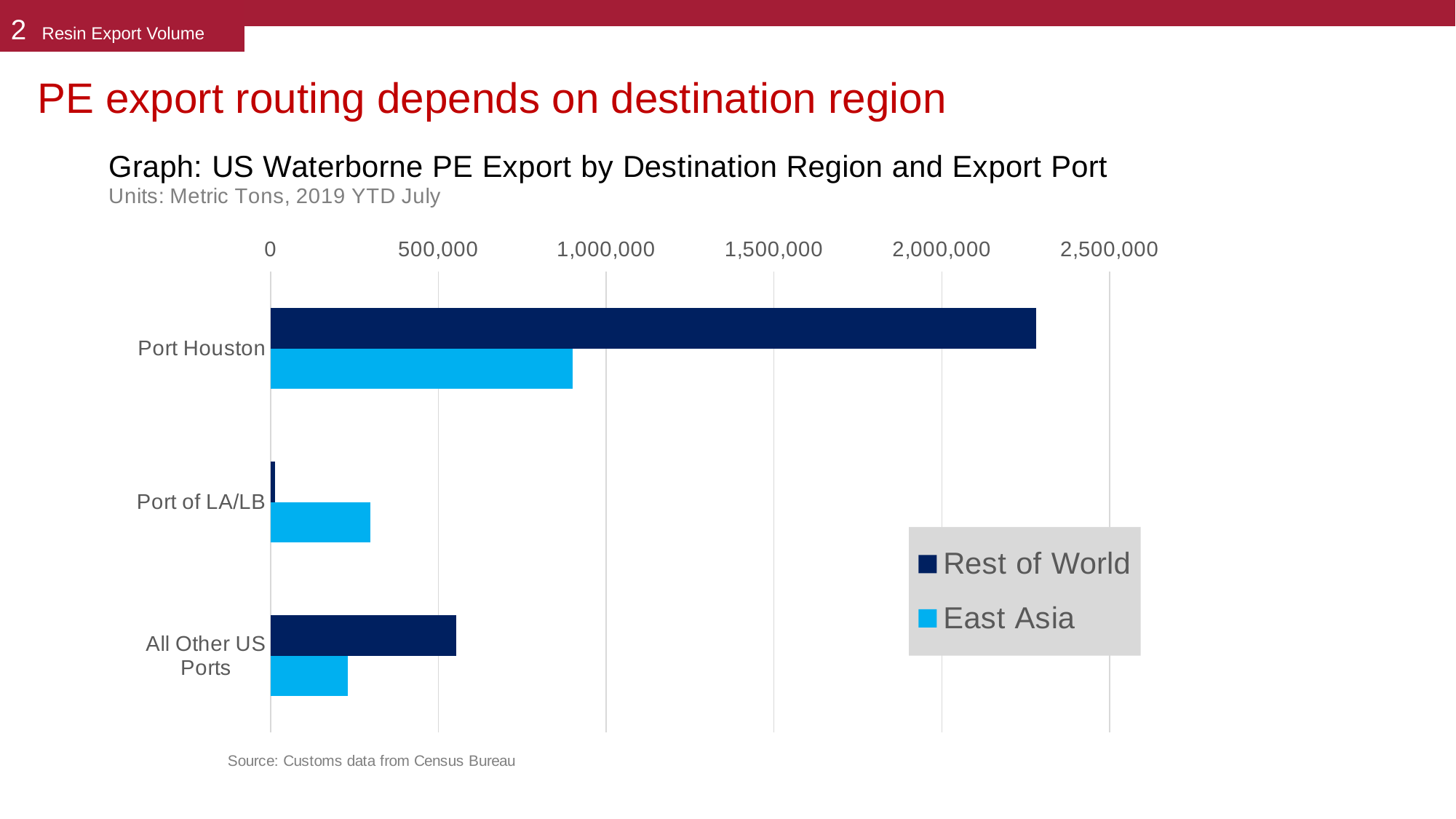
Which port has the highest Rest of World export volume? Port Houston Which port has the lowest East Asia export volume? All Other US Ports How many ports (categories) are shown on the chart? 3 What units are the values on the chart measured in? Metric Tons Which port has the lowest Rest of World export volume? Port of LA/LB Is the Rest of World value for Port Houston greater or less than 2,000,000? greater Which port has the highest East Asia export volume? Port Houston Is the East Asia value for Port Houston greater or less than 1,000,000? less What kind of chart is shown on the slide? bar chart For Port of LA/LB, which is larger: Rest of World or East Asia? East Asia For All Other US Ports, which is larger: Rest of World or East Asia? Rest of World How many series does the legend list? 2